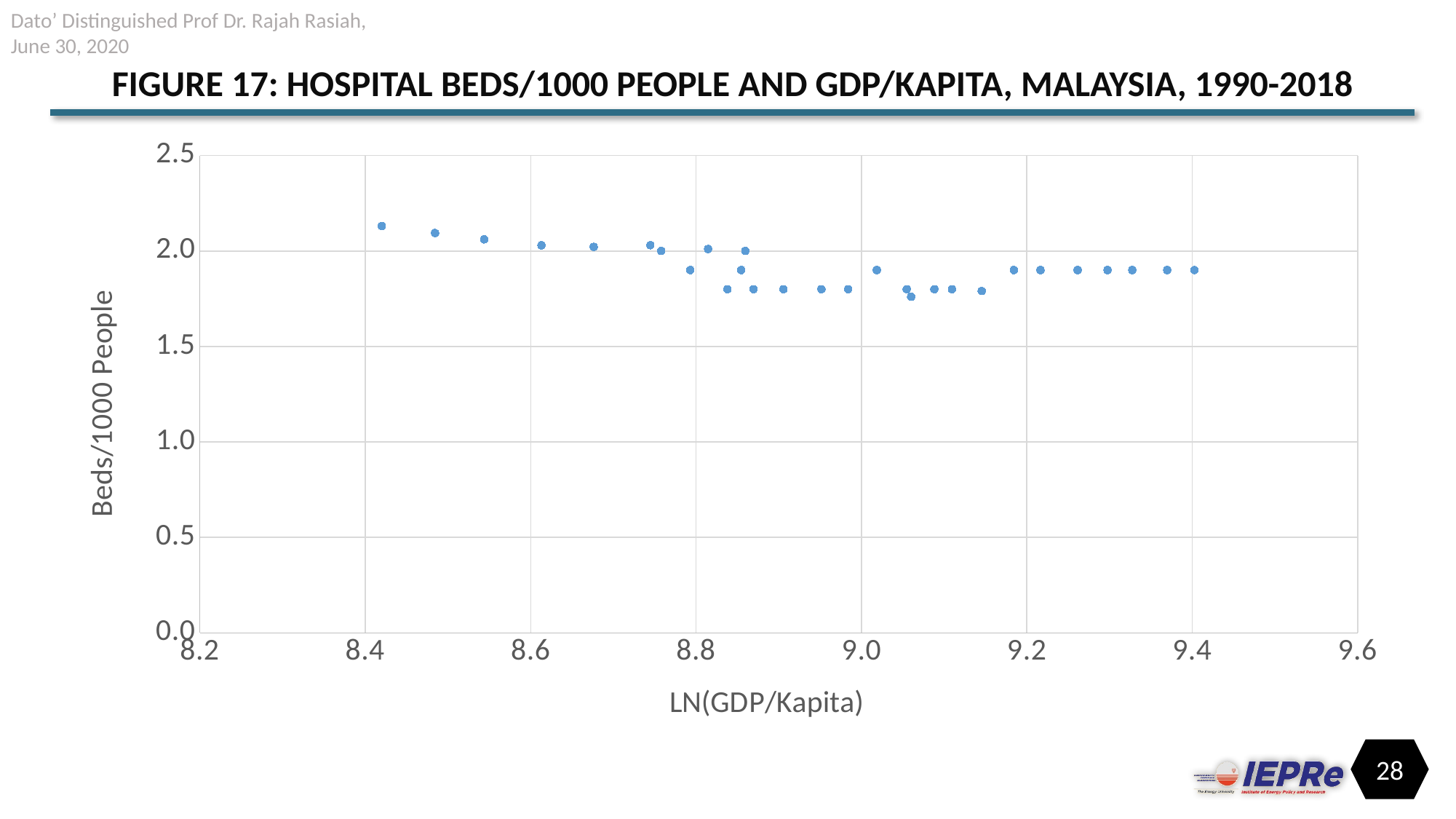
Which has the higher Beds/1000 People value: the point near LN(GDP/Kapita) 8.4 or the point near LN(GDP/Kapita) 9.4? the point near 8.4 What is the title of the chart? FIGURE 17: HOSPITAL BEDS/1000 PEOPLE AND GDP/KAPITA, MALAYSIA, 1990-2018 Do the Beds/1000 People values generally rise or fall as LN(GDP/Kapita) increases? fall What is the highest value shown on the y axis? 2.5 What is the label of the x axis? LN(GDP/Kapita) Is the Beds/1000 People value for the point with the lowest LN(GDP/Kapita) greater or less than 2.0? greater How many data points are plotted on the chart? 29 Is the highest Beds/1000 People value on the chart greater or less than 2.5? less What kind of chart is shown on the slide? scatter chart Is the Beds/1000 People value for the point with the highest LN(GDP/Kapita) greater or less than 2.0? less